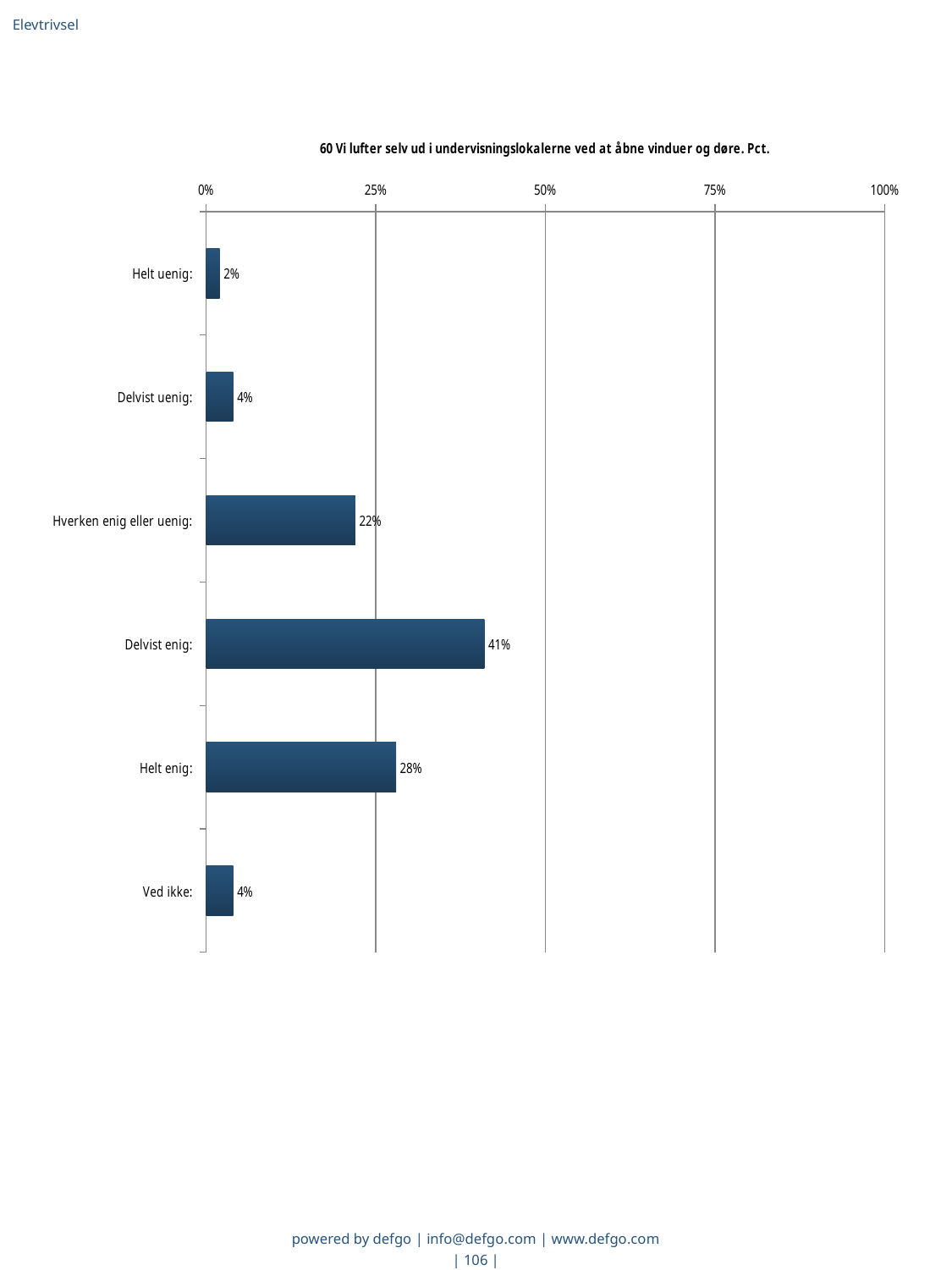
What is the value for "Helt enig"? 28% Which category has the highest value? Delvist enig Is the value for "Delvist enig" greater or less than 25%? greater What is the value for "Delvist enig"? 41% How many categories are shown on the chart? 6 What is the difference between the values for "Delvist enig" and "Helt enig"? 13% What kind of chart is shown on the slide? Bar chart Which category has the lowest value? Helt uenig Which is larger, the value for "Hverken enig eller uenig" or the value for "Helt enig"? Helt enig What is the title of the chart? 60 Vi lufter selv ud i undervisningslokalerne ved at åbne vinduer og døre. Pct. What is the value for "Hverken enig eller uenig"? 22% What is the value for "Helt uenig"? 2%